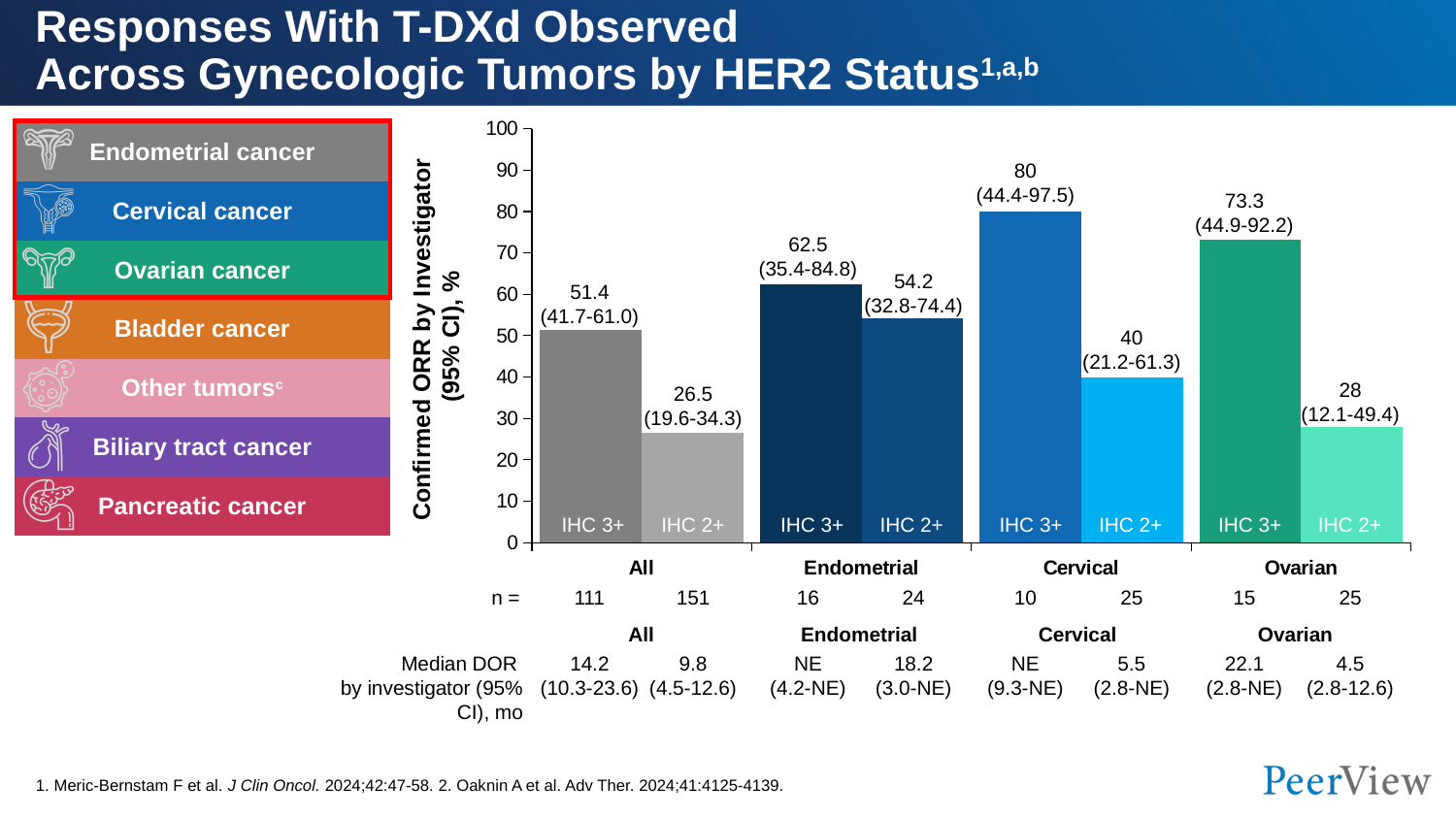
What is the confirmed ORR for the IHC 2+ bar in the All group? 26.5 What is the confirmed ORR for the IHC 3+ bar in the Ovarian group? 73.3 What is the difference in confirmed ORR between the Endometrial IHC 3+ and Endometrial IHC 2+ bars? 8.3 How many bars are plotted in the chart? 8 What is the label of the y axis of the chart? Confirmed ORR by Investigator (95% CI), % Which bar has the highest confirmed ORR? Cervical IHC 3+ What is the 95% CI shown for the Endometrial IHC 2+ bar? (32.8-74.4) Which is larger, the confirmed ORR for Ovarian IHC 3+ or Endometrial IHC 3+? Ovarian IHC 3+ Which bar has the lowest confirmed ORR? All IHC 2+ What is the difference in confirmed ORR between the Cervical IHC 3+ and Cervical IHC 2+ bars? 40 What type of chart is shown on the slide? Bar chart What is the confirmed ORR for the IHC 3+ bar in the Cervical group? 80